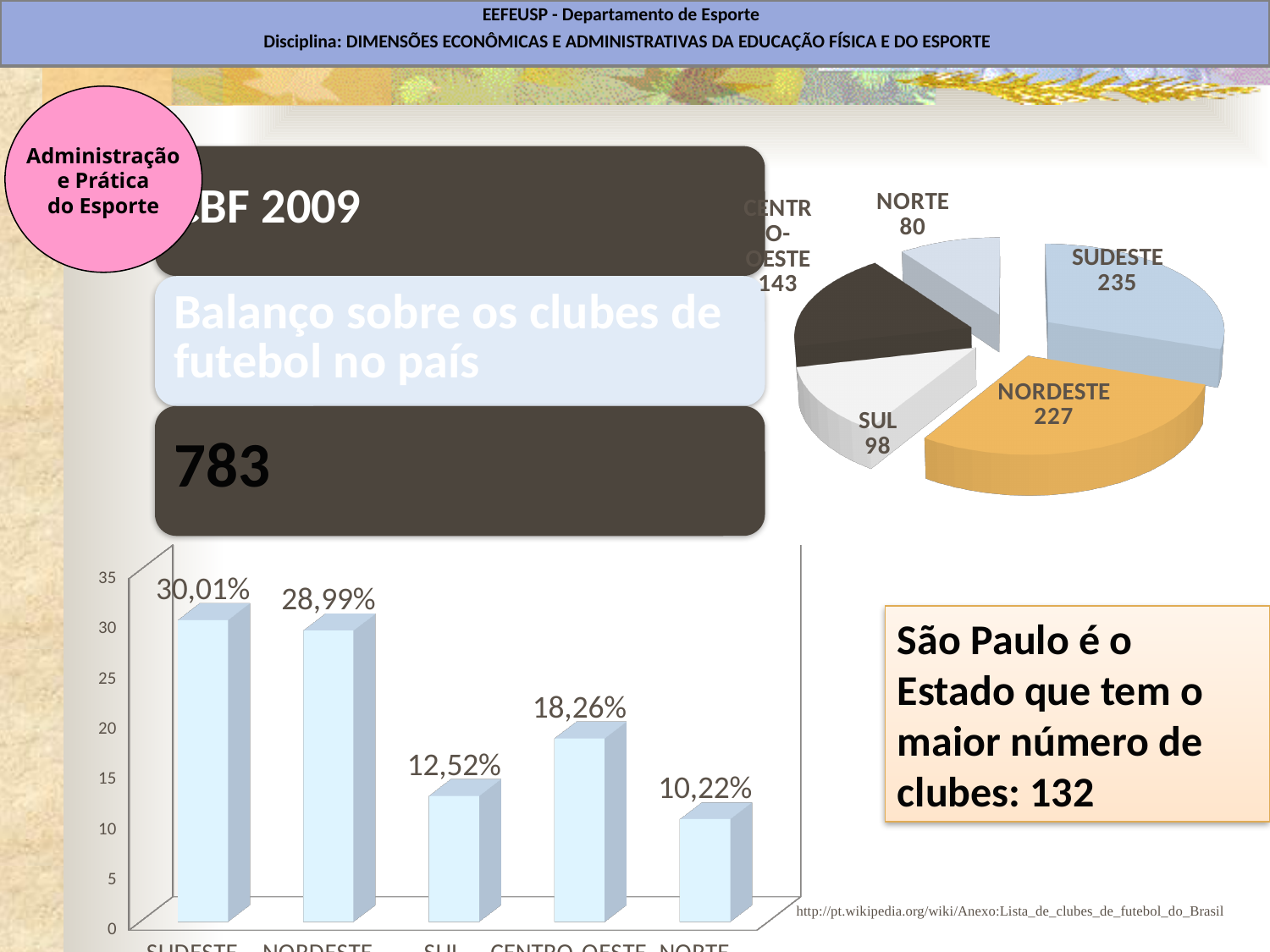
In the pie chart at the top right, how many clubs does the SUDESTE slice show? 235 In the pie chart at the top right, what value is shown for NORDESTE? 227 In the bar chart at the bottom left, what percentage is shown on the fourth bar (CENTRO-OESTE)? 18,26% In the pie chart at the top right, what is the difference between the SUDESTE and SUL values? 137 In the bar chart at the bottom left, which is larger, the SUL bar or the CENTRO-OESTE bar? CENTRO-OESTE In the pie chart at the top right, which region has the smallest value? NORTE In the bar chart at the bottom left, what percentage is shown on the first bar (SUDESTE)? 30,01% What type of chart is shown at the bottom left of the slide? bar chart In the pie chart at the top right, what value is shown for NORTE? 80 In the bar chart at the bottom left, which bar is the lowest? NORTE In the pie chart at the top right, how many slices are there? 5 In the pie chart at the top right, which region has the largest value? SUDESTE